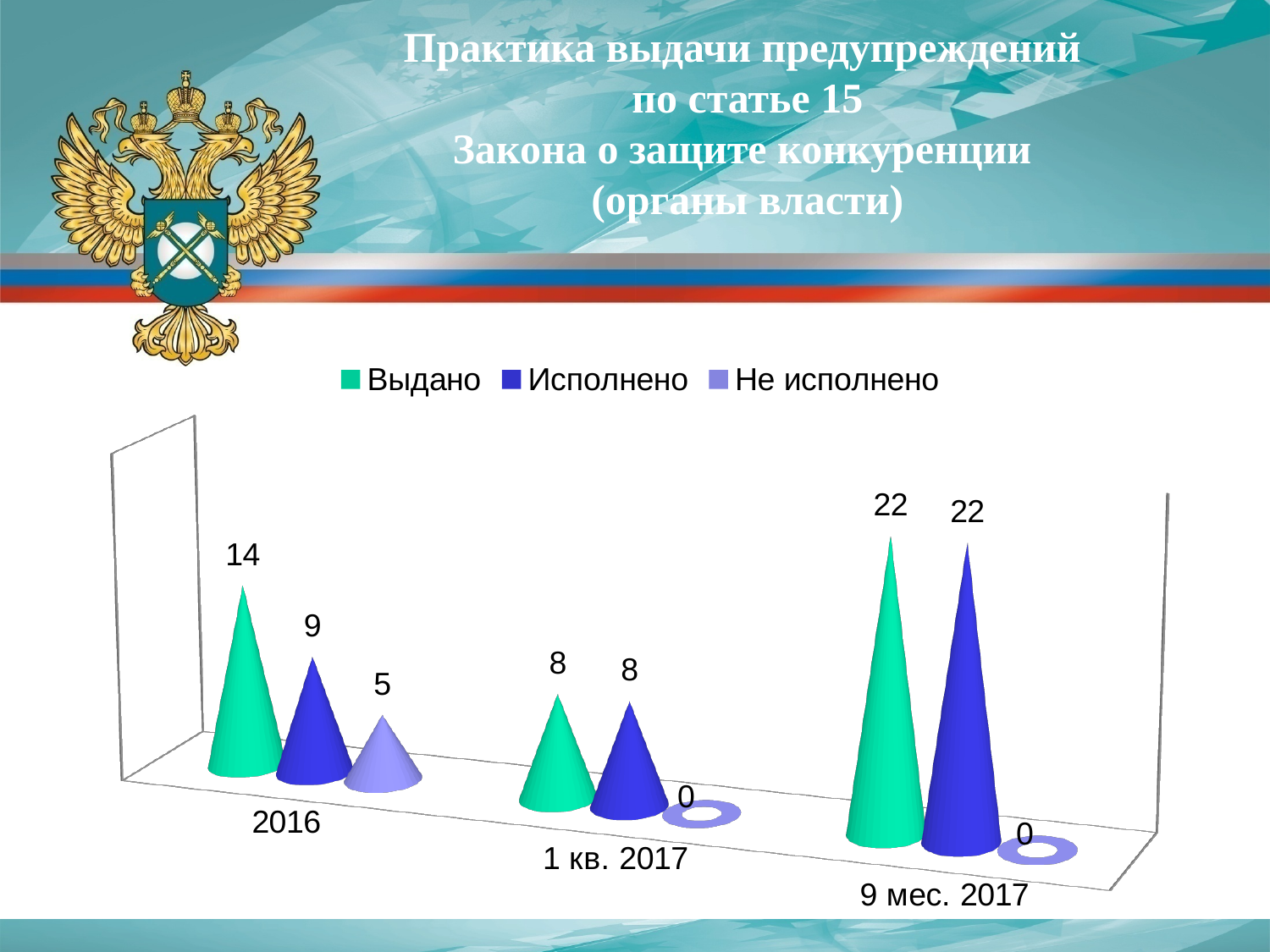
What is the value of Не исполнено for 2016? 5 Which category has the lowest value for Исполнено? 1 кв. 2017 What kind of chart is shown on the slide? bar chart What is the value of Исполнено for 2016? 9 How many categories are shown on the x axis? 3 What is the difference between Выдано and Исполнено for 2016? 5 What is the value of Выдано for 9 мес. 2017? 22 What is the value of Не исполнено for 1 кв. 2017? 0 How many series does the legend list? 3 What is the value of Выдано for 2016? 14 Which is larger: Выдано for 2016 or Выдано for 1 кв. 2017? Выдано for 2016 Which category has the highest value for Выдано? 9 мес. 2017